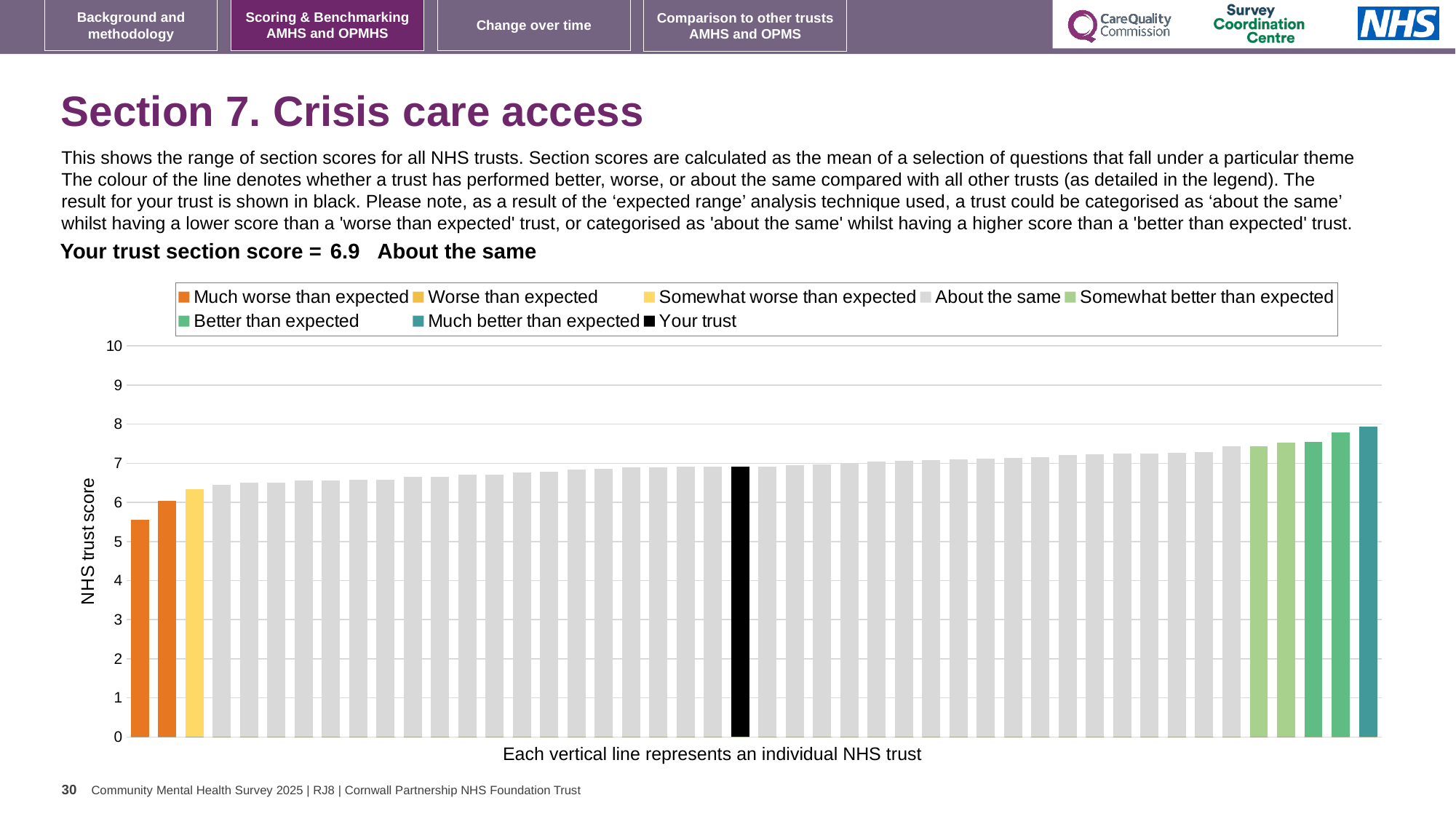
How many bars are coloured as 'Much worse than expected'? 2 Which legend category does the shortest bar belong to? Much worse than expected What is the section score for your trust shown on the slide? 6.9 How many bars are coloured as 'Much better than expected'? 1 Is the value of the lowest bar in the chart greater or less than 6? less Is the value of the highest bar in the chart greater or less than 7? greater Which benchmarking category is your trust placed in for Section 7? About the same What kind of chart is shown on the slide? bar chart Do the bar values rise or fall from left to right along the x axis? rise What is the label on the vertical axis of the chart? NHS trust score How many entries does the chart legend list? 8 Which legend category does the tallest bar belong to? Much better than expected